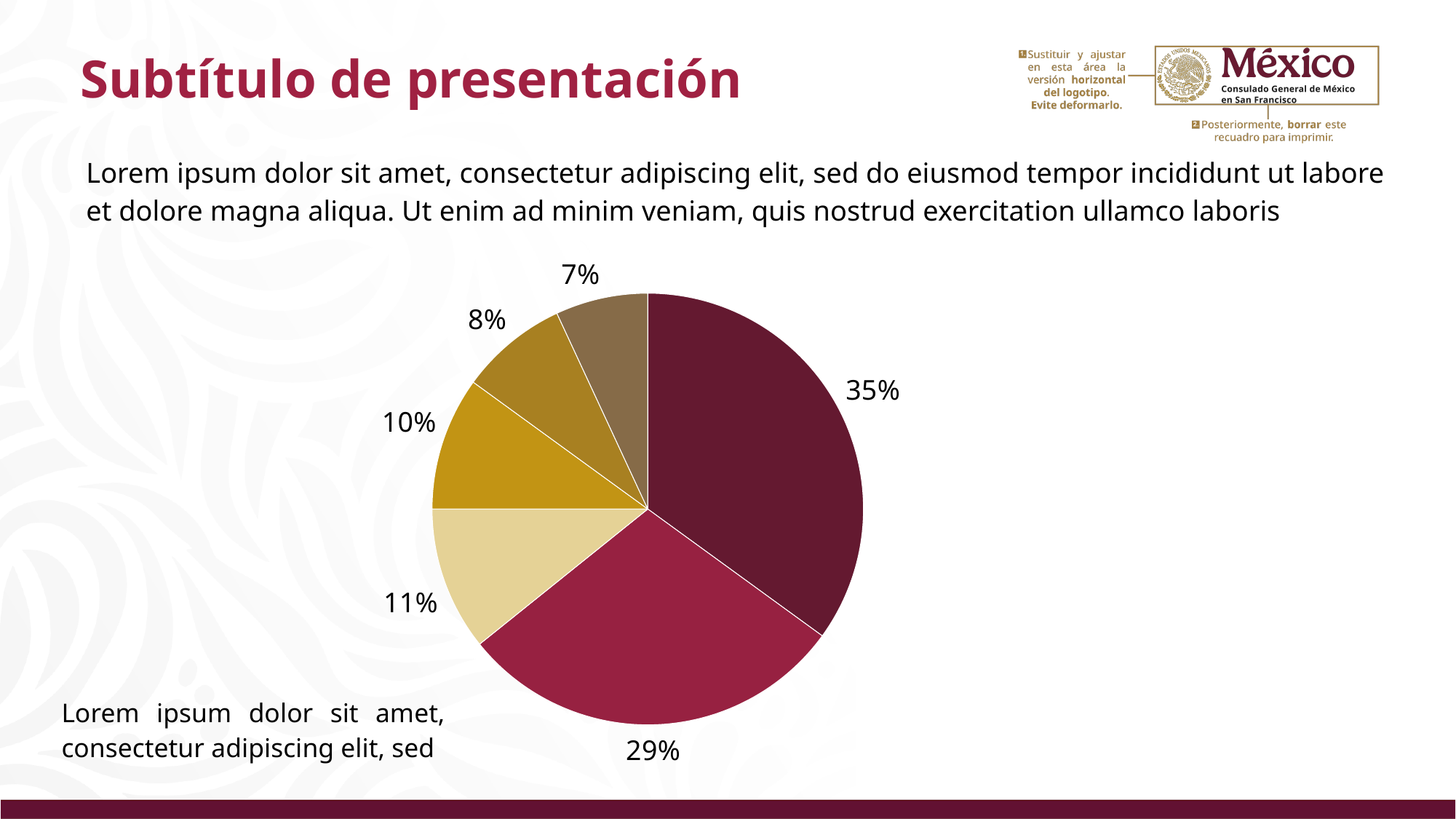
Which slice is larger, the gold slice labelled 10% or the light tan slice labelled 11%? the light tan slice (11%) What percentage is shown for the brown slice at the top of the pie chart? 7% What is the difference in percentage points between the largest slice (35%) and the second largest slice (29%)? 6 What percentage is shown for the dark maroon slice of the pie chart? 35% How many slices does the pie chart have? 6 What percentage is shown for the light tan slice of the pie chart? 11% What is the smallest share shown in the pie chart? 7% What percentage is shown for the crimson (bright red) slice of the pie chart? 29% Do the two maroon/red slices together make up more or less than half of the pie? more Does the pie chart include a legend with category names? No What kind of chart is shown on the slide? pie chart What is the largest share shown in the pie chart? 35%